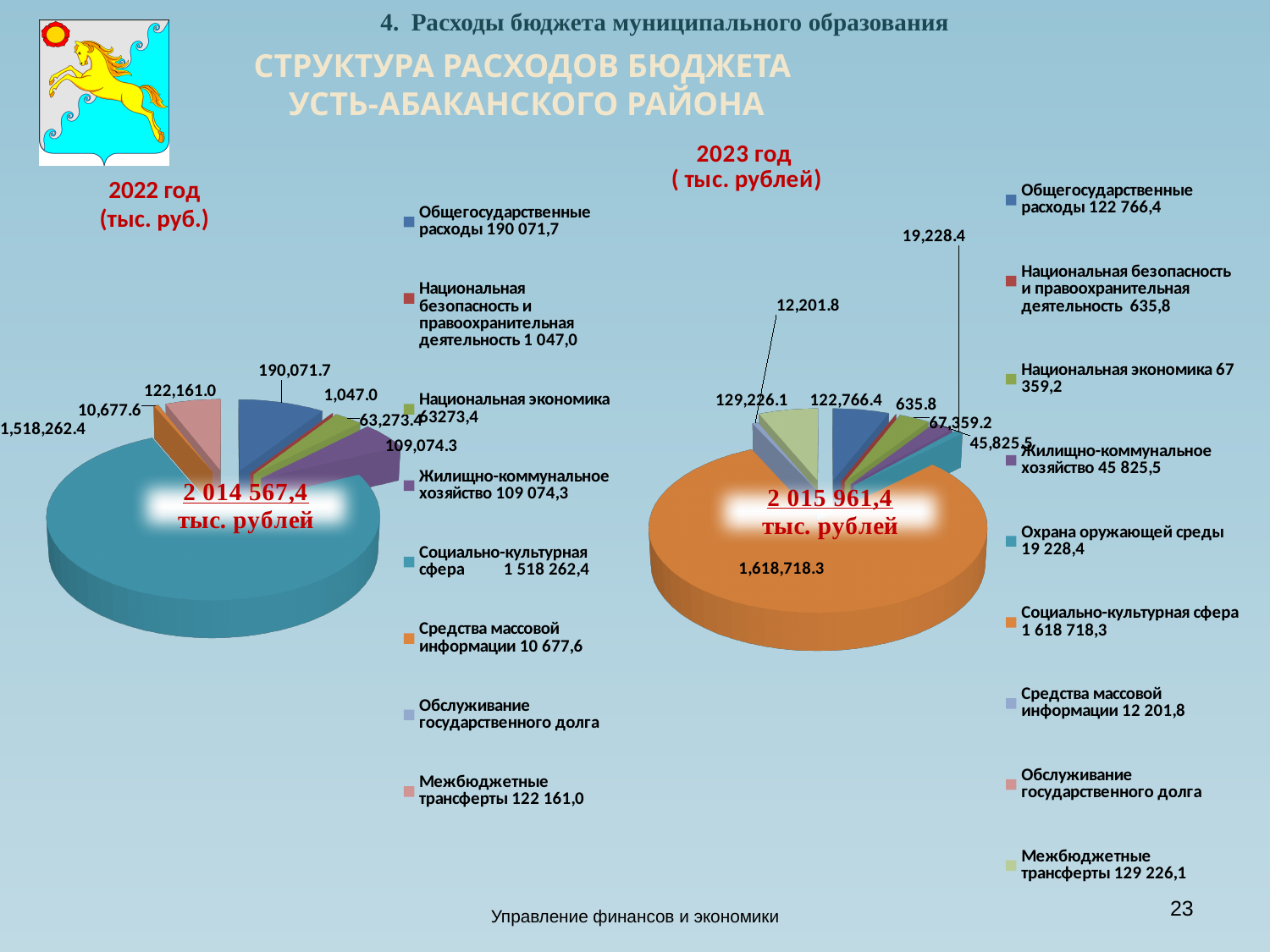
On the 2022 pie chart, what is the value for Общегосударственные расходы? 190,071.7 On the 2022 pie chart, what is the difference between Общегосударственные расходы and Жилищно-коммунальное хозяйство? 80,997.4 On the 2022 pie chart, what is the value for Средства массовой информации? 10,677.6 On the 2023 pie chart, what is the value for Межбюджетные трансферты? 129,226.1 On the 2023 pie chart, what is the value for Охрана окружающей среды? 19,228.4 On the 2023 pie chart, which is larger: Национальная экономика or Жилищно-коммунальное хозяйство? Национальная экономика On the 2022 pie chart, which category has the largest slice? Социально-культурная сфера Which is larger: Межбюджетные трансферты on the 2023 chart or on the 2022 chart? 2023 chart What total is printed in the centre of the 2023 pie chart? 2 015 961,4 тыс. рублей On the 2023 pie chart, which category has the smallest labelled value? Национальная безопасность и правоохранительная деятельность How many entries does the legend of the 2023 pie chart list? 9 What type of chart is used for the 2022 budget expenditure structure? Pie chart